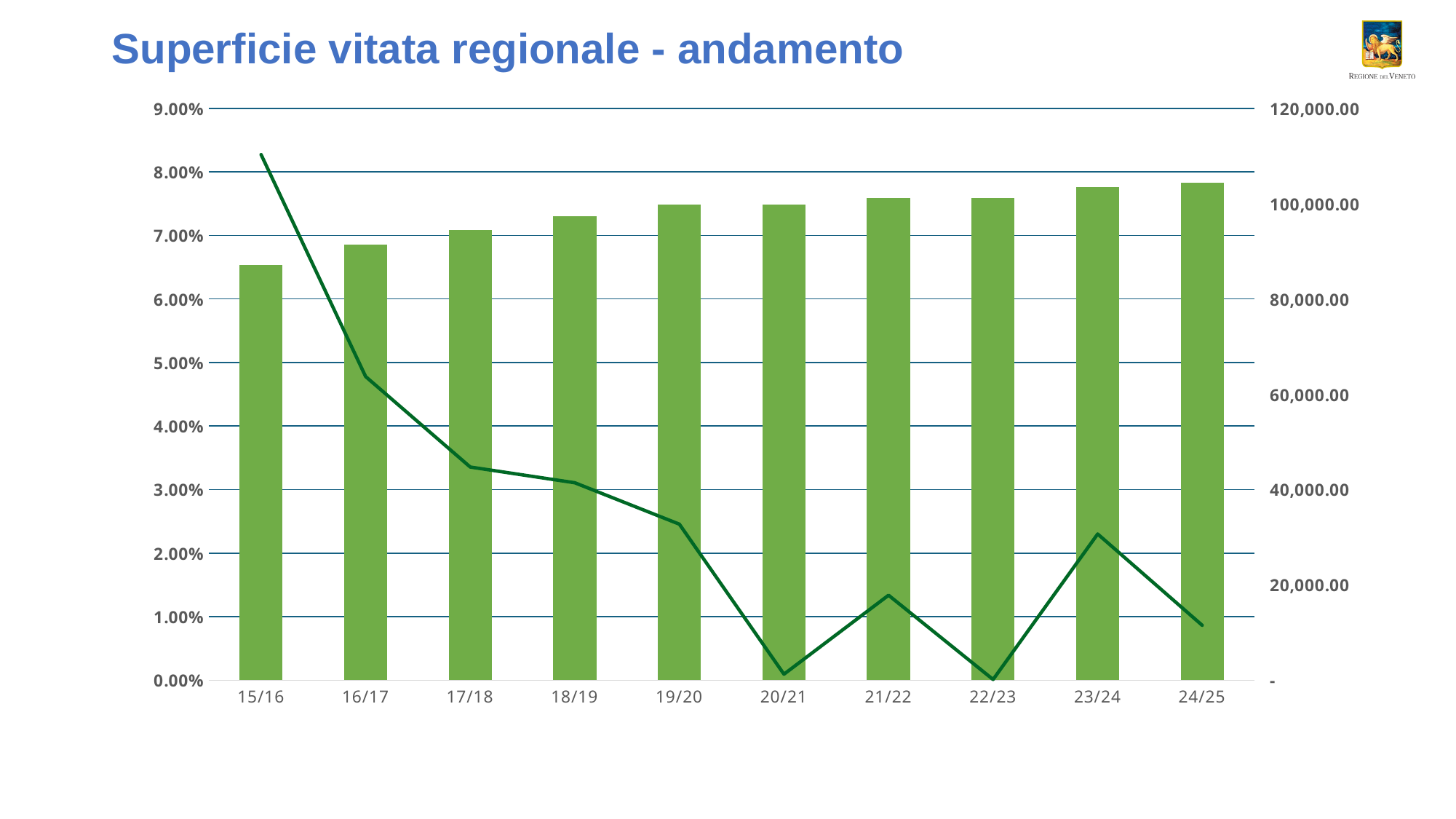
Which season has the shortest green bar? 15/16 Is the line value for 15/16 greater or less than 8.00% on the left axis? greater What kind of chart is shown on the slide? A combined bar and line chart Is the green bar for 24/25 greater or less than 100,000.00 on the right axis? greater Which is larger, the line value for 15/16 or the line value for 16/17? 15/16 What is the title of the chart on the slide? Superficie vitata regionale - andamento Which season has the tallest green bar? 24/25 Is the line value for 19/20 greater or less than 3.00% on the left axis? less At which season does the dark green line reach its highest point? 15/16 Do the green bars generally rise or fall from 15/16 to 24/25? Rise How many categories (seasons) are shown on the x axis? 10